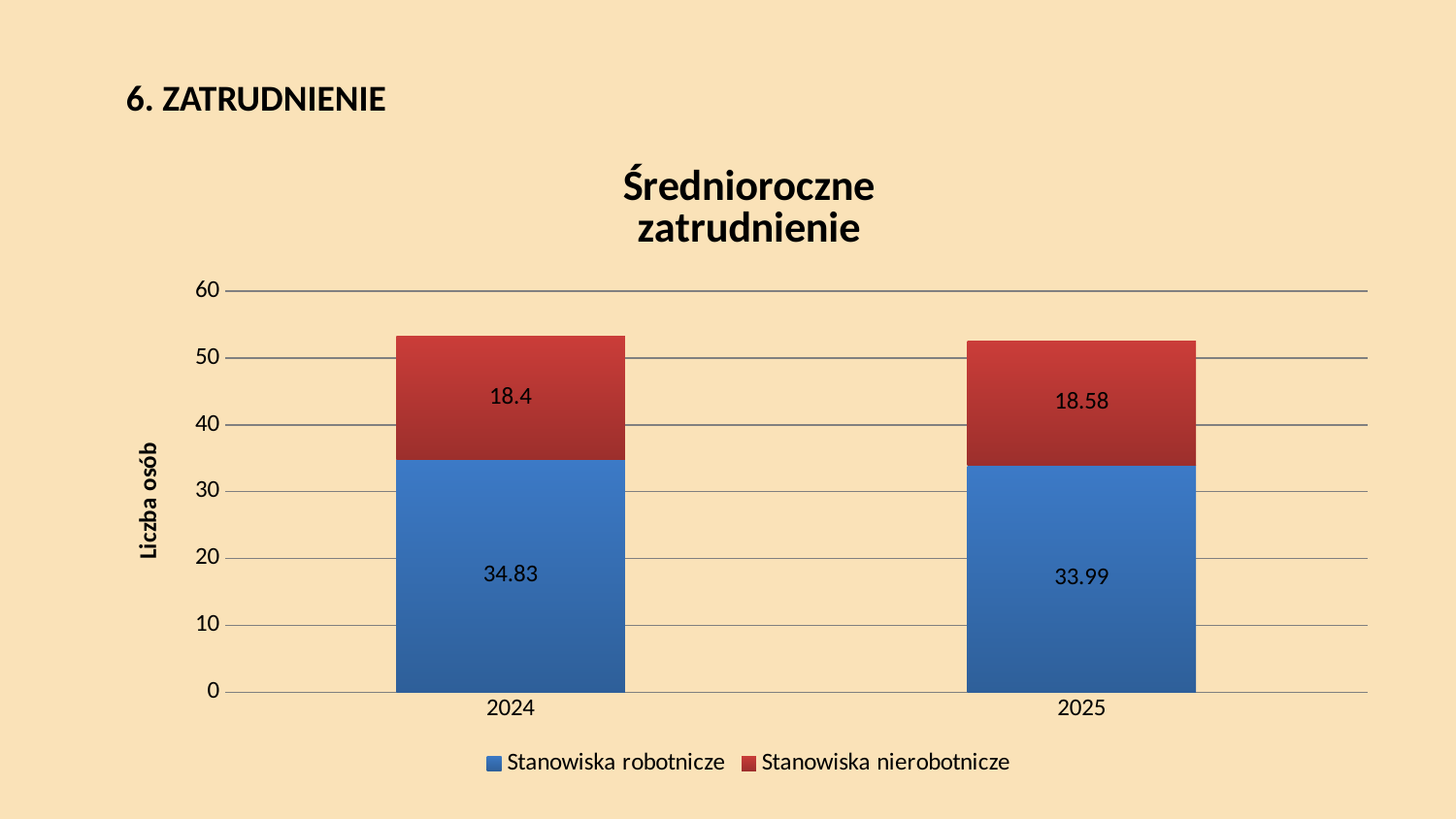
How many series does the legend list? 2 What is the value for Stanowiska robotnicze in 2024? 34.83 Which year has the higher value for Stanowiska nierobotnicze, 2024 or 2025? 2025 What is the total of the stacked bar for 2024? 53.23 What is the total of the stacked bar for 2025? 52.57 Is the total of the stacked bar for 2024 greater or less than 50? greater What is the title of the chart? Średnioroczne zatrudnienie What is the difference between the Stanowiska robotnicze values for 2024 and 2025? 0.84 What kind of chart is shown on the slide? Stacked bar chart What is the value for Stanowiska nierobotnicze in 2024? 18.4 What is the value for Stanowiska nierobotnicze in 2025? 18.58 What is the value for Stanowiska robotnicze in 2025? 33.99